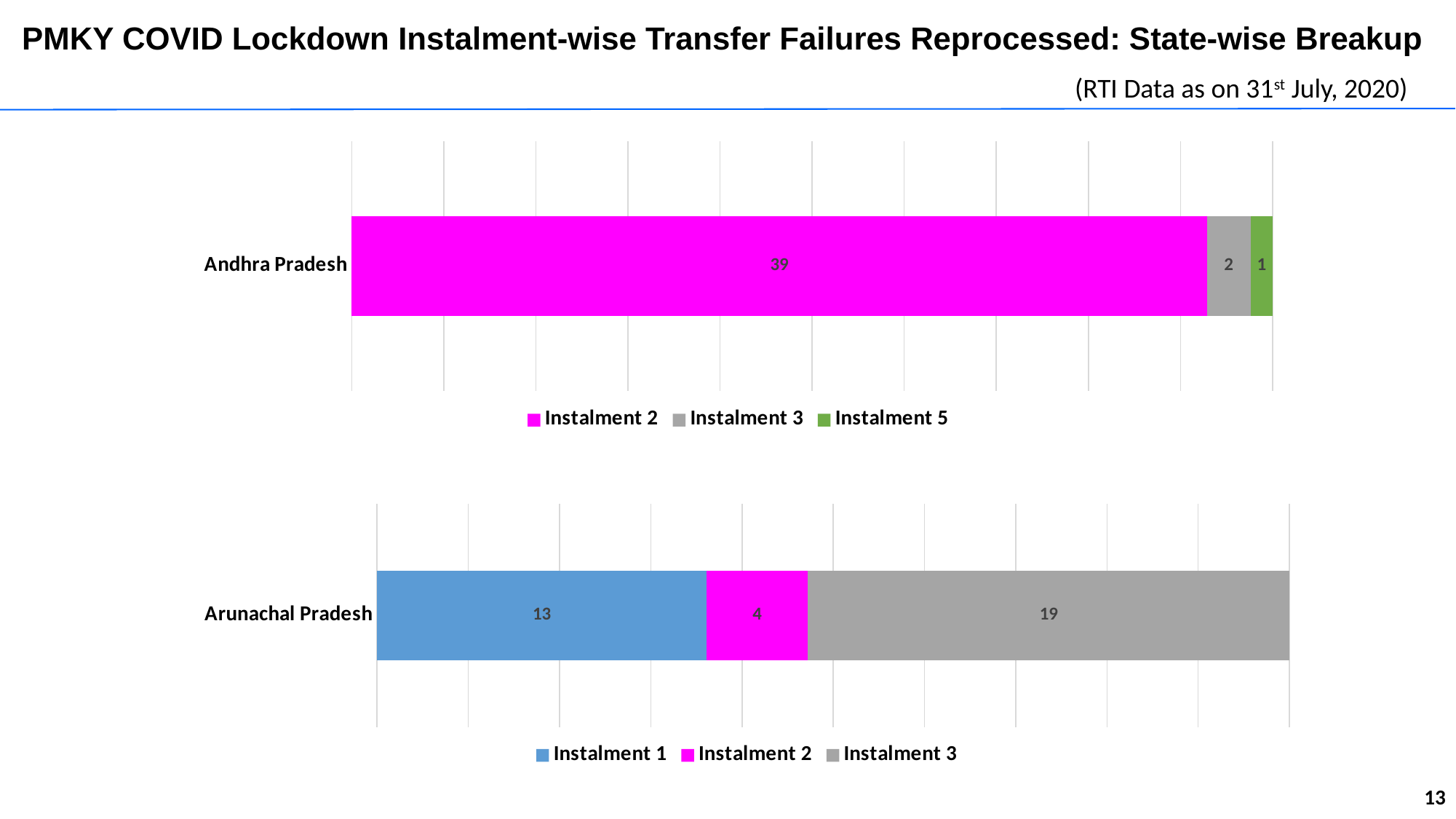
How many series does the legend of the Arunachal Pradesh chart list? 3 In the Arunachal Pradesh chart, what is the difference between the Instalment 3 and Instalment 1 values? 6 In the Andhra Pradesh chart, what is the value for Instalment 2? 39 In the Andhra Pradesh chart, what is the value for Instalment 3? 2 In the Andhra Pradesh chart, what is the total of the stacked bar? 42 In the Andhra Pradesh chart, which instalment has the lowest value? Instalment 5 In the Arunachal Pradesh chart, what is the value for Instalment 3? 19 In the Andhra Pradesh chart, what is the value for Instalment 5? 1 What kind of chart is the Andhra Pradesh chart? Stacked bar chart In the Arunachal Pradesh chart, what is the total of the stacked bar? 36 In the Arunachal Pradesh chart, what is the value for Instalment 1? 13 In the Arunachal Pradesh chart, which instalment has the highest value? Instalment 3